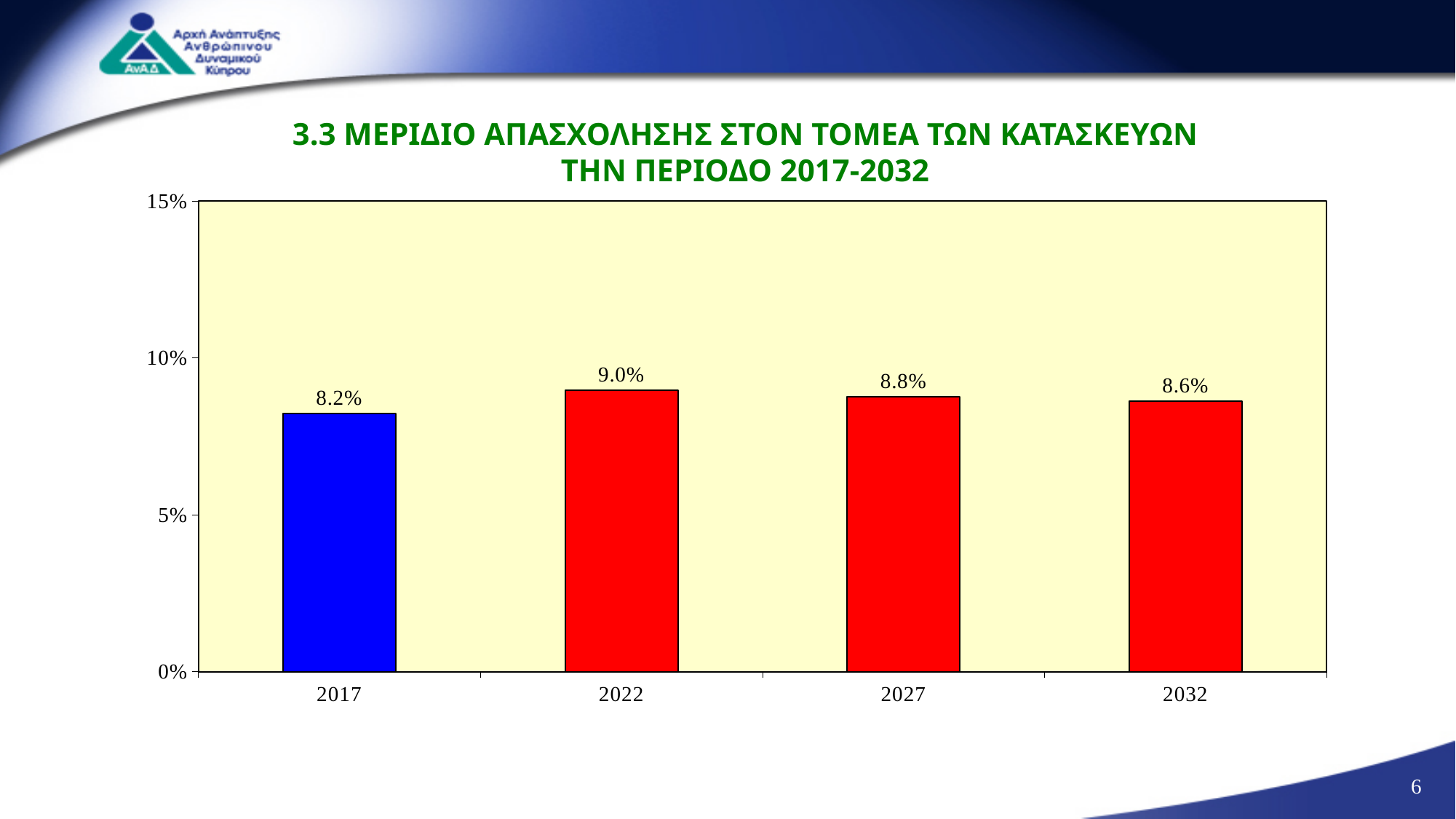
Which is larger, the value for 2027 or the value for 2032? 2027 What kind of chart is shown on the slide? bar chart What is the value for 2027? 8.8% Do the values rise or fall from 2022 to 2032? fall Which year has the lowest value? 2017 What is the value for 2032? 8.6% What is the value for 2017? 8.2% What is the value for 2022? 9.0% How many years are shown on the x axis? 4 Which year has the highest value? 2022 What is the difference between the values for 2022 and 2017? 0.8% Is the value for 2022 greater or less than 10%? less